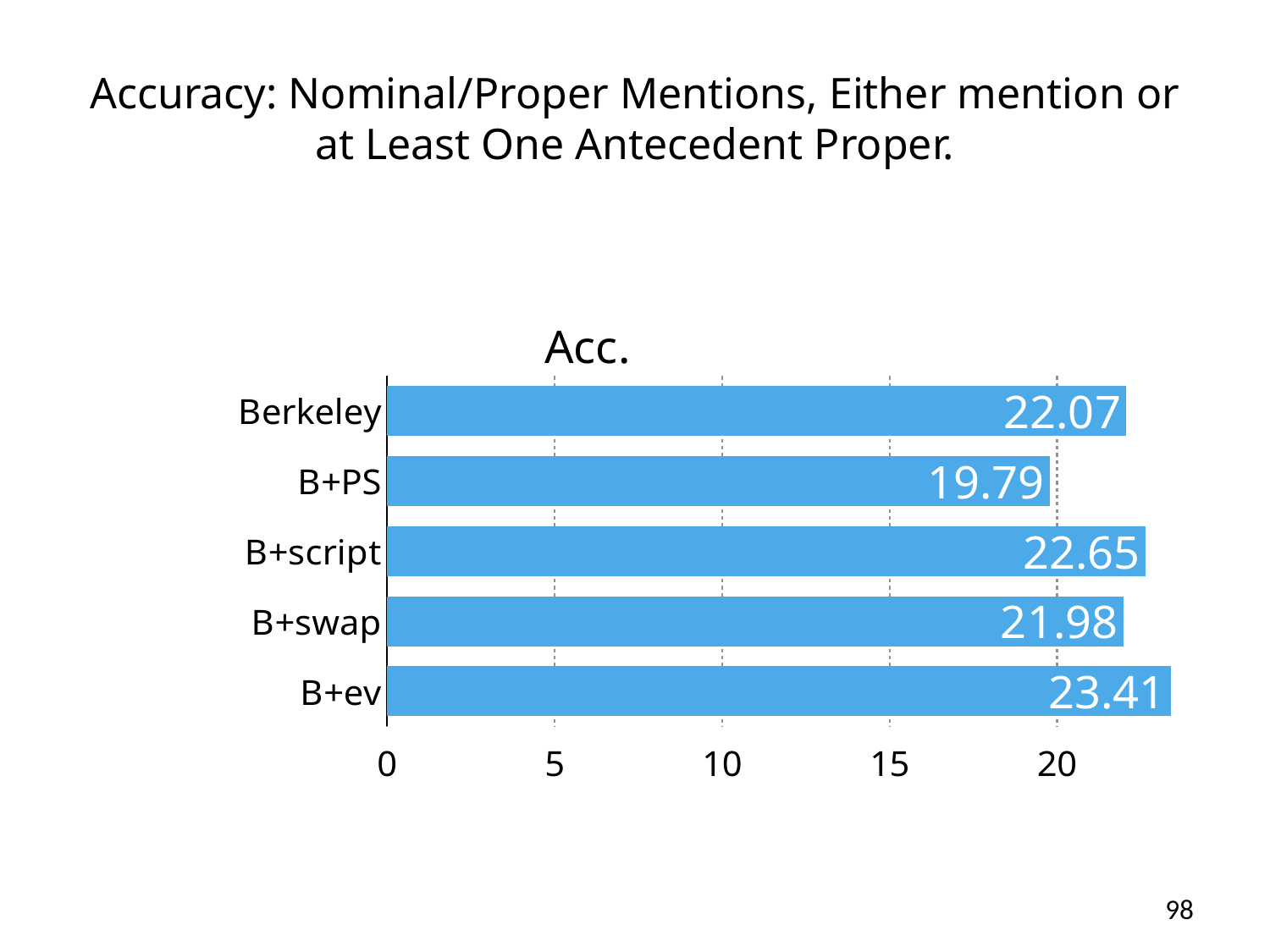
What is the Acc. value for B+swap? 21.98 Is the value for B+PS greater or less than 20? less What is the Acc. value for Berkeley? 22.07 How many categories are shown in the chart? 5 Which has a higher Acc. value, B+script or B+swap? B+script What kind of chart is shown on the slide? bar chart What is the Acc. value for B+PS? 19.79 What is the Acc. value for B+ev? 23.41 Which category has the lowest Acc. value? B+PS What is the Acc. value for B+script? 22.65 Which category has the highest Acc. value? B+ev What is the difference between the Acc. values for B+ev and B+PS? 3.62